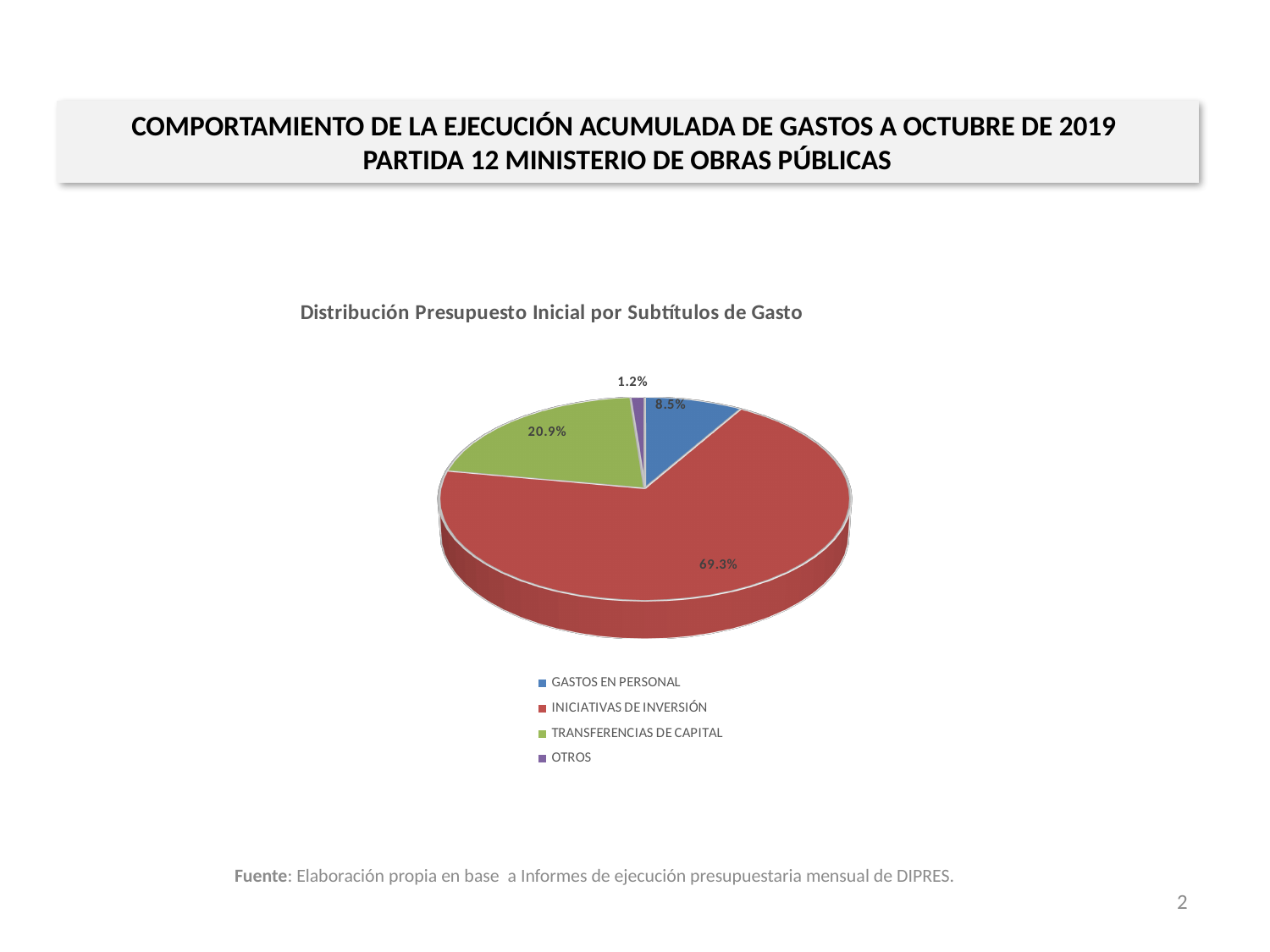
How many categories does the pie chart show? 4 Which category has the smallest slice of the pie? OTROS Which category has the largest slice of the pie? INICIATIVAS DE INVERSIÓN What is the difference in percentage points between the INICIATIVAS DE INVERSIÓN share and the TRANSFERENCIAS DE CAPITAL share? 48.4 What share of the pie does INICIATIVAS DE INVERSIÓN represent? 69.3% What colour is the slice for INICIATIVAS DE INVERSIÓN? Red What kind of chart is shown on the slide? Pie chart What share of the pie does GASTOS EN PERSONAL represent? 8.5% What is the title of the chart? Distribución Presupuesto Inicial por Subtítulos de Gasto What share of the pie does TRANSFERENCIAS DE CAPITAL represent? 20.9% Which is larger, the share for TRANSFERENCIAS DE CAPITAL or the share for GASTOS EN PERSONAL? TRANSFERENCIAS DE CAPITAL